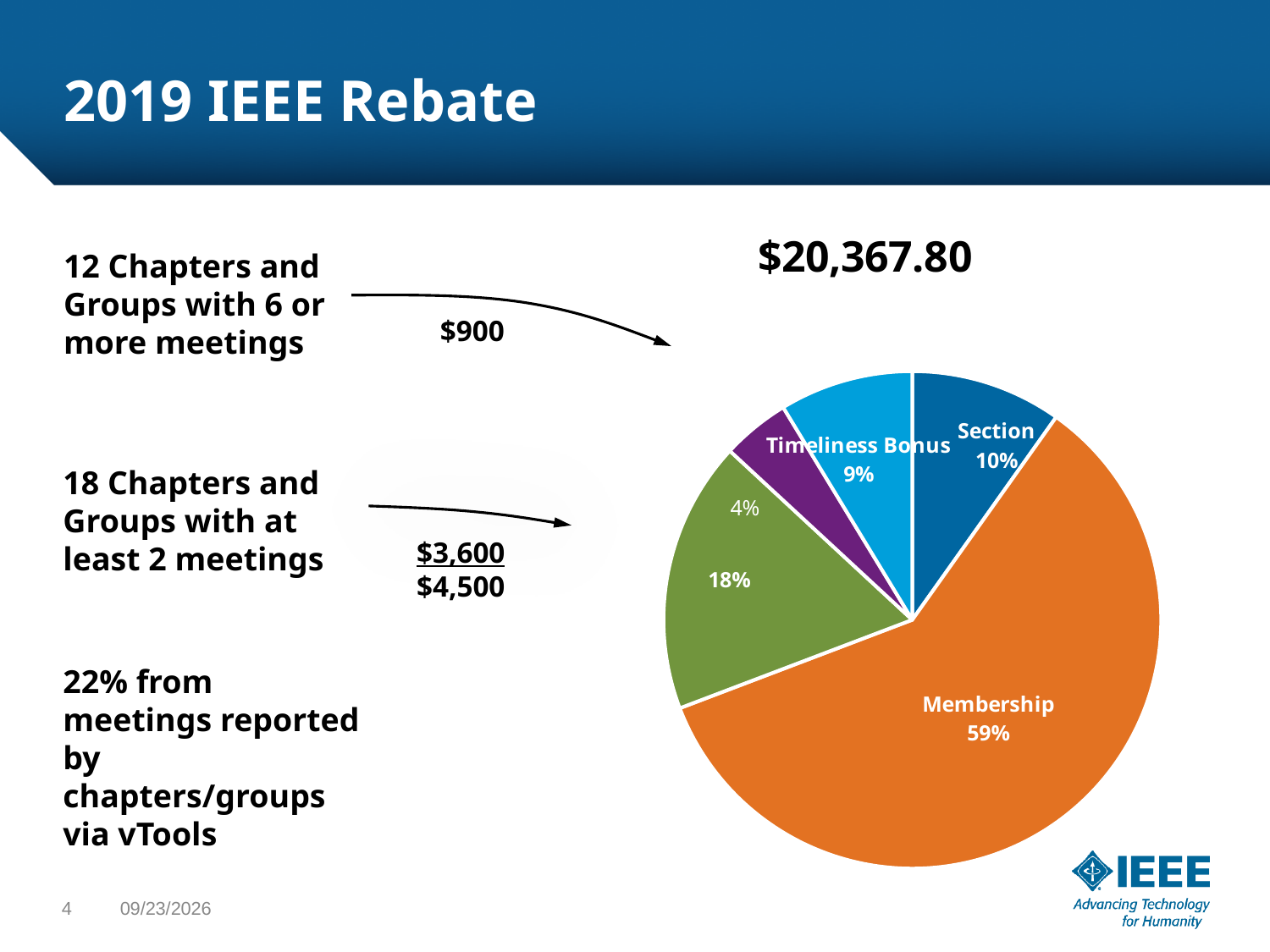
How many slices does the pie chart have? 5 What percentage is printed on the green slice of the pie? 18% Which is larger, the Section slice or the Timeliness Bonus slice? Section What percentage is shown for the Section slice? 10% What type of chart is shown on the slide? pie chart What percentage is printed on the purple slice of the pie? 4% What percentage is shown for the Timeliness Bonus slice? 9% Which slice of the pie is the largest? Membership What share of the pie does Membership account for? 59% What is the difference between the Section share and the Timeliness Bonus share? 1% How many percentage points larger is the Membership slice than the Section slice? 49% What colour is the Membership slice of the pie? orange